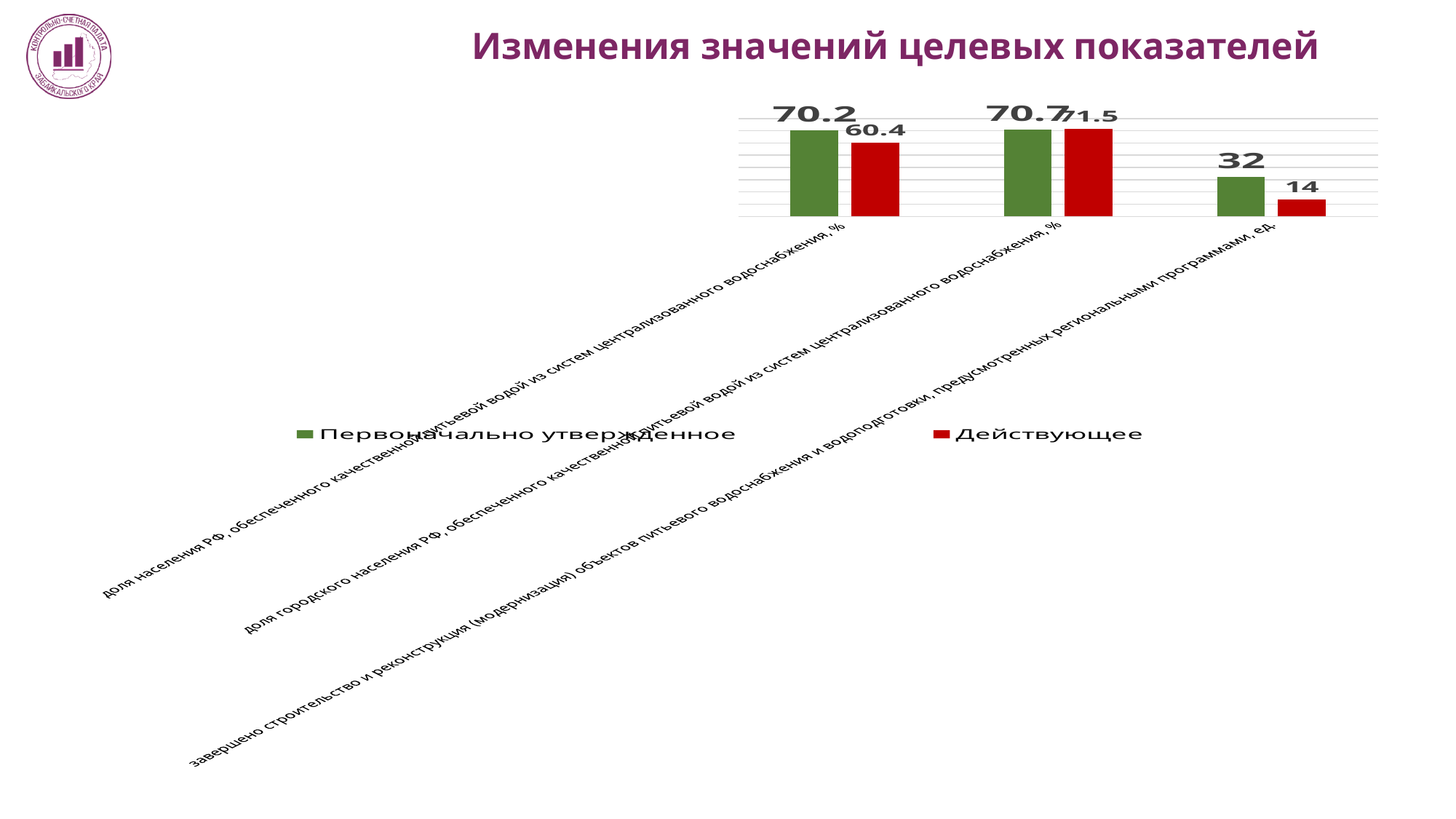
How many categories are shown on the x axis? 3 How many series does the legend list? 2 What colour are the bars for the 'Действующее' series? red What is the 'Первоначально утвержденное' value for 'завершено строительство и реконструкция (модернизация) объектов питьевого водоснабжения и водоподготовки, предусмотренных региональными программами, ед.'? 32 What type of chart is shown on the slide? bar chart What is the title of the chart? Изменения значений целевых показателей For 'доля населения РФ, обеспеченного качественной питьевой водой из систем централизованного водоснабжения, %', which series has the larger value: 'Первоначально утвержденное' or 'Действующее'? Первоначально утвержденное Which category has the lowest 'Действующее' value? завершено строительство и реконструкция (модернизация) объектов питьевого водоснабжения и водоподготовки, предусмотренных региональными программами, ед. What is the 'Действующее' value for 'доля городского населения РФ, обеспеченного качественной питьевой водой из систем централизованного водоснабжения, %'? 71.5 What is the 'Действующее' value for 'доля населения РФ, обеспеченного качественной питьевой водой из систем централизованного водоснабжения, %'? 60.4 What is the difference between the 'Первоначально утвержденное' and 'Действующее' values for 'завершено строительство и реконструкция (модернизация) объектов питьевого водоснабжения и водоподготовки, предусмотренных региональными программами, ед.'? 18 What is the 'Первоначально утвержденное' value for 'доля населения РФ, обеспеченного качественной питьевой водой из систем централизованного водоснабжения, %'? 70.2